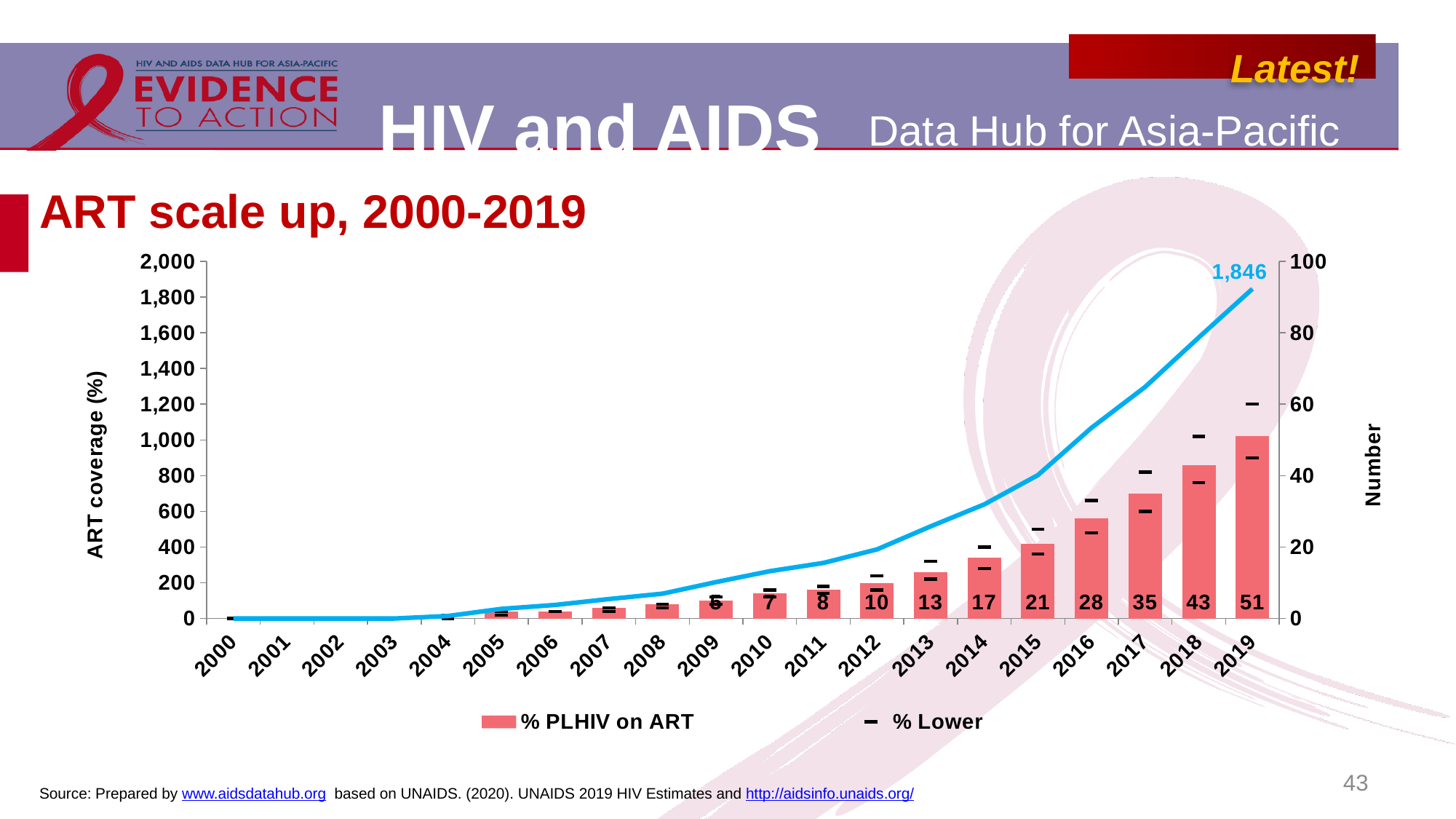
What is the % PLHIV on ART value for 2015? 21 Which is larger, the % PLHIV on ART value for 2017 or for 2014? 2017 How many entries does the legend list? 2 Do the % PLHIV on ART bars rise or fall from 2000 to 2019? rise What value is labelled on the blue line for 2019? 1,846 What is the % PLHIV on ART value for 2018? 43 How many years are shown on the x axis? 20 What is the difference between the % PLHIV on ART values for 2016 and 2015? 7 Is the value of the blue line for 2015 greater or less than 1,000 on the left axis? less What is the % PLHIV on ART value for 2019? 51 Which year has the highest % PLHIV on ART bar? 2019 What is the difference between the % PLHIV on ART values for 2019 and 2018? 8